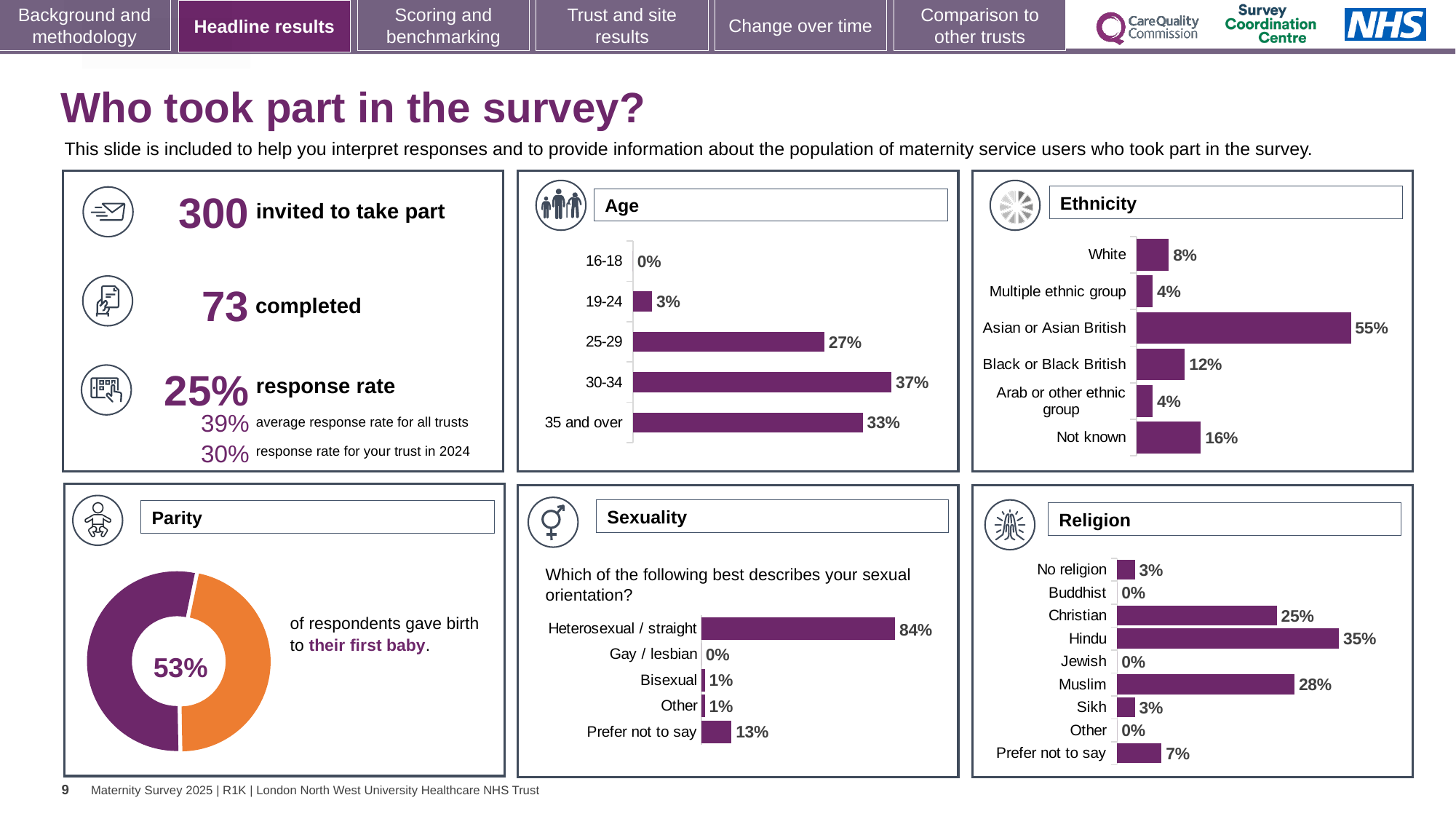
In the Ethnicity chart, what is the value for Asian or Asian British? 55% What kind of chart is the Parity chart? Doughnut chart In the Parity chart, what percentage of respondents gave birth to their first baby? 53% In the Ethnicity chart, what is the difference between Black or Black British and White? 4% In the Religion chart, is the value for Christian larger or smaller than the value for Muslim? smaller In the Sexuality chart, what percentage of respondents answered Prefer not to say? 13% In the Age chart, which age group has the highest percentage? 30-34 In the Age chart, what percentage of respondents were aged 30-34? 37% How many categories are shown in the Ethnicity chart? 6 In the Religion chart, what is the value for Muslim? 28% In the Religion chart, which religion has the highest percentage? Hindu How many categories are shown in the Sexuality chart? 5